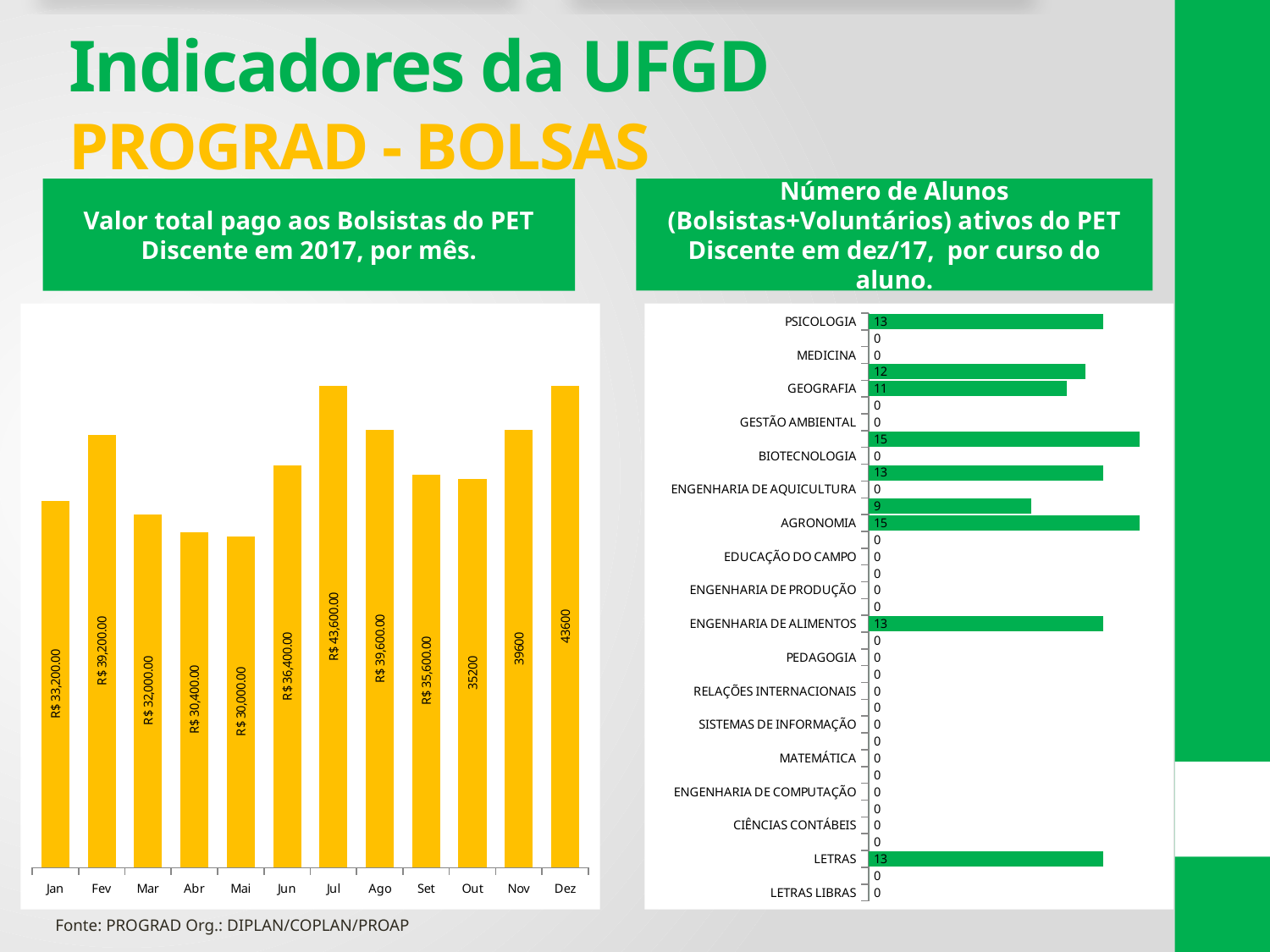
In the right chart (Número de Alunos ativos do PET Discente em dez/17, por curso do aluno), what is the value for AGRONOMIA? 15 In the left chart (Valor total pago aos Bolsistas do PET Discente em 2017, por mês), which is larger, the value for Ago or the value for Set? Ago In the left chart (Valor total pago aos Bolsistas do PET Discente em 2017, por mês), which month has the lowest value? Mai In the left chart (Valor total pago aos Bolsistas do PET Discente em 2017, por mês), what is the value for Jan? R$ 33,200.00 In the right chart (Número de Alunos ativos do PET Discente em dez/17, por curso do aluno), which is larger, the value for PSICOLOGIA or the value for GEOGRAFIA? PSICOLOGIA In the right chart (Número de Alunos ativos do PET Discente em dez/17, por curso do aluno), what is the difference between the values for AGRONOMIA and LETRAS? 2 In the left chart (Valor total pago aos Bolsistas do PET Discente em 2017, por mês), what is the value for Out? 35200 In the left chart (Valor total pago aos Bolsistas do PET Discente em 2017, por mês), what is the value for Jul? R$ 43,600.00 In the left chart (Valor total pago aos Bolsistas do PET Discente em 2017, por mês), what is the difference between the values for Fev and Mar? R$ 7,200.00 In the right chart (Número de Alunos ativos do PET Discente em dez/17, por curso do aluno), what is the value for GEOGRAFIA? 11 In the left chart (Valor total pago aos Bolsistas do PET Discente em 2017, por mês), how many months are plotted? 12 What kind of chart is the left chart (Valor total pago aos Bolsistas do PET Discente em 2017, por mês)? Bar chart